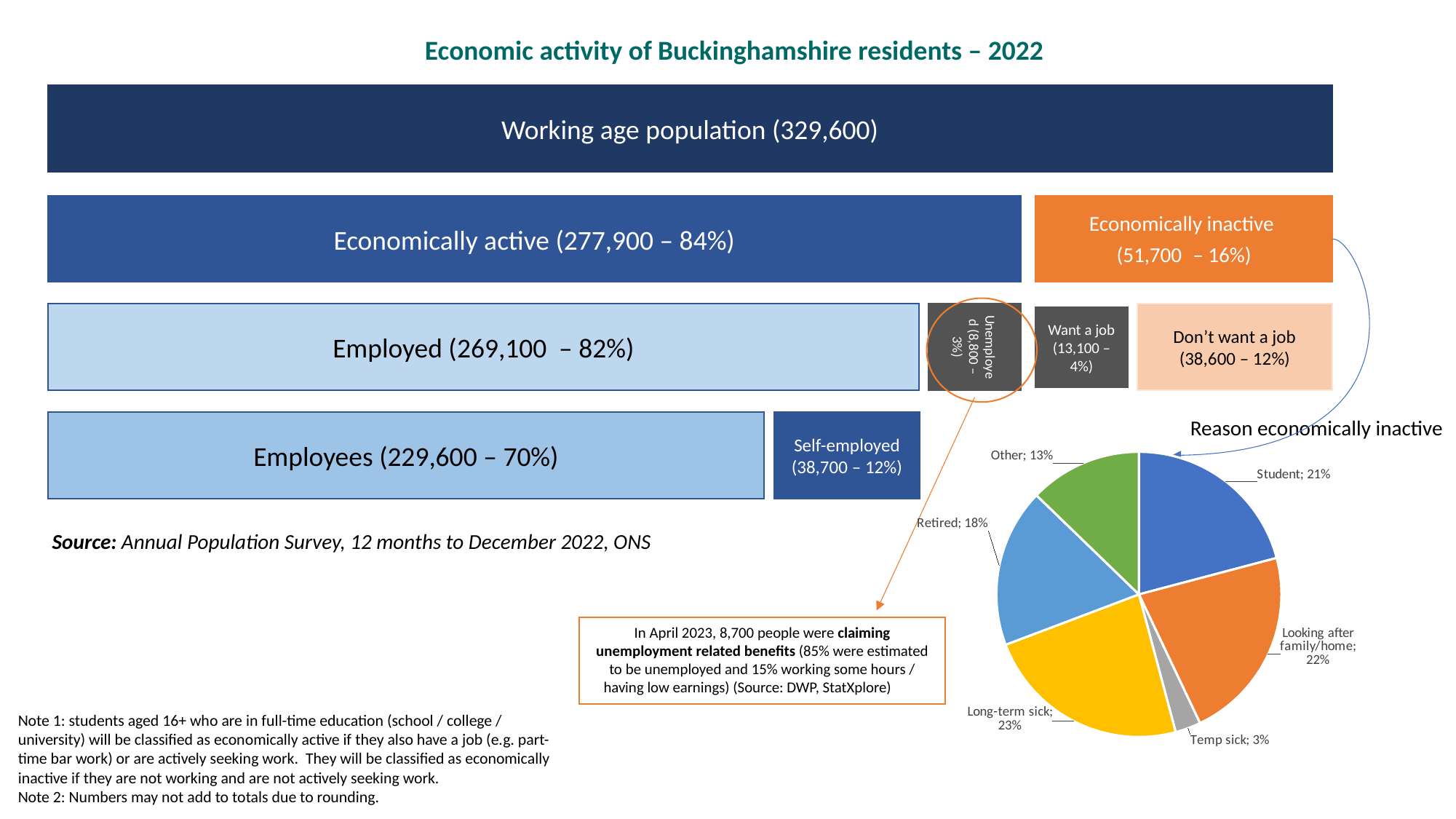
In the pie chart 'Reason economically inactive', what share is labelled for Retired? 18% In the pie chart 'Reason economically inactive', what share of the pie does the Long-term sick slice represent? 23% In the pie chart 'Reason economically inactive', what is the difference in percentage points between the Student and Other slices? 8 What kind of chart is used to show the reasons for being economically inactive? Pie chart In the pie chart 'Reason economically inactive', which reason has the smallest slice? Temp sick In the pie chart 'Reason economically inactive', what share is labelled for Other? 13% In the pie chart 'Reason economically inactive', what share is labelled for Student? 21% In the pie chart 'Reason economically inactive', which slice is larger, Retired or Other? Retired In the pie chart 'Reason economically inactive', which reason has the largest labelled share? Long-term sick In the pie chart 'Reason economically inactive', how many slices are there? 6 In the pie chart 'Reason economically inactive', what share is labelled for Looking after family/home? 22% What is the title of the pie chart on the slide? Reason economically inactive